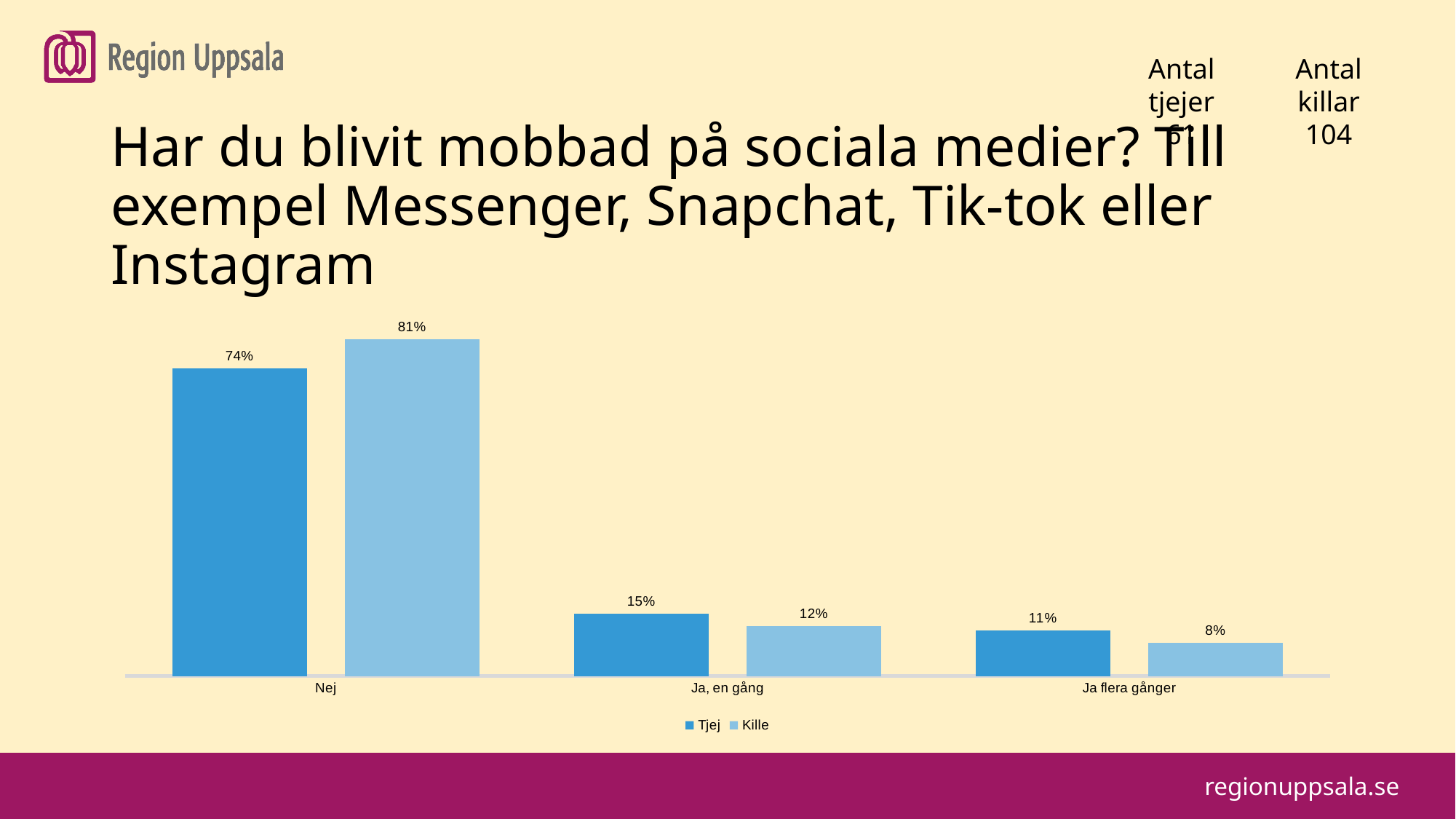
Which category has the highest value for the Kille series? Nej What is the value for Kille in the Nej category? 81% What is the difference between the Tjej and Kille values in the 'Ja, en gång' category? 3% What is the value for Tjej in the 'Ja, en gång' category? 15% How many series does the legend list? 2 Which category has the lowest value for the Tjej series? Ja flera gånger Which is larger in the 'Ja flera gånger' category, Tjej or Kille? Tjej What is the value for Kille in the 'Ja flera gånger' category? 8% What is the value for Tjej in the Nej category? 74% What kind of chart is shown on the slide? Bar chart How many categories are shown on the x axis? 3 What is the difference between the Kille and Tjej values in the Nej category? 7%